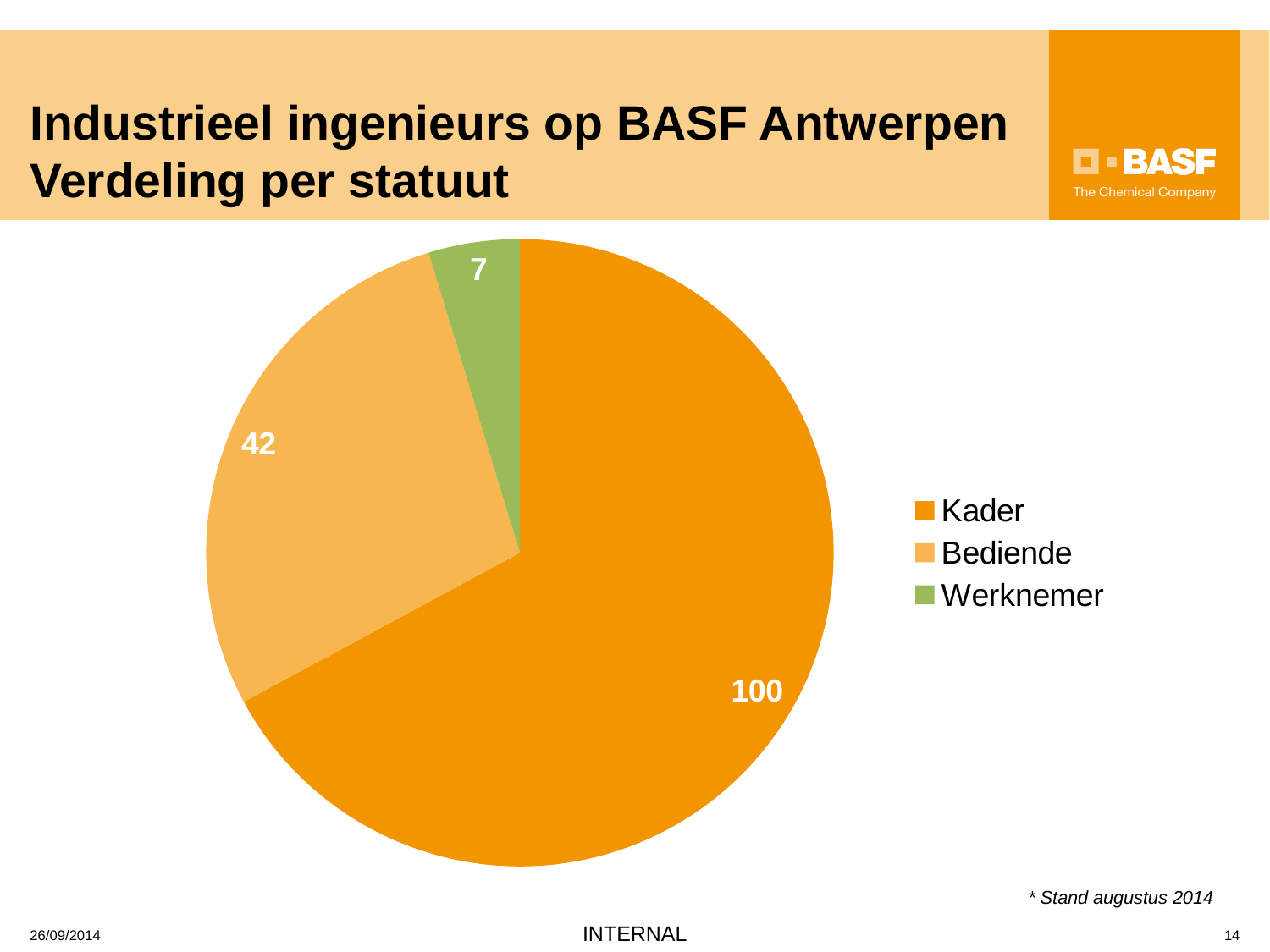
What is the total of all slices in the pie chart? 149 Which colour represents Werknemer in the legend? green What is the difference between the values for Bediende and Werknemer? 35 What is the difference between the values for Kader and Bediende? 58 How many categories does the pie chart have? 3 What is the value for Werknemer? 7 What is the value for Bediende? 42 Which category has the smallest slice of the pie? Werknemer Which is larger, the value for Bediende or the value for Werknemer? Bediende Which category has the largest slice of the pie? Kader What is the value for Kader? 100 What kind of chart is shown on the slide? pie chart